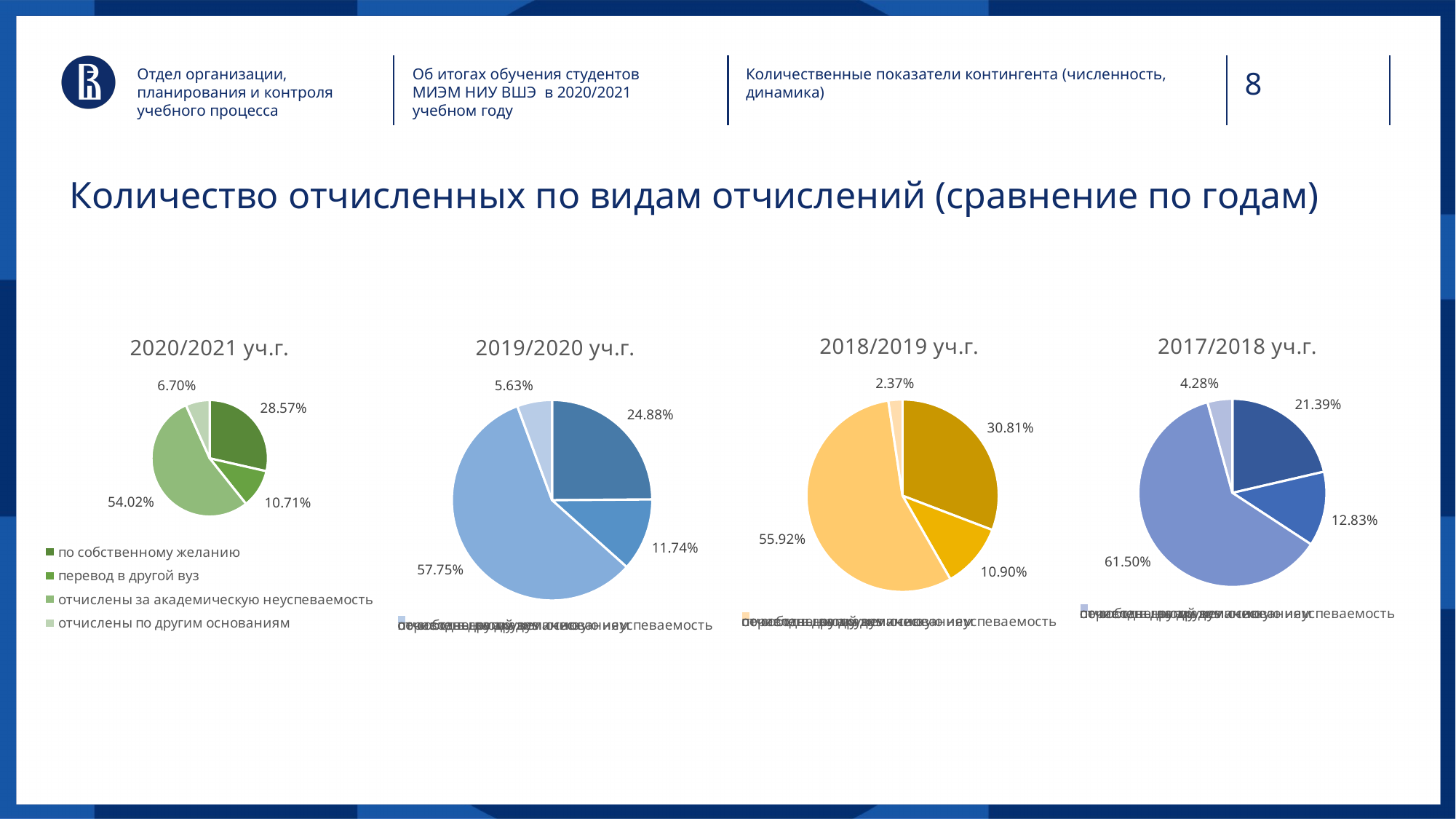
How many categories does the legend of the 2020/2021 уч.г. pie chart list? 4 What kind of chart is used for the 2020/2021 уч.г. data? pie chart In the 2020/2021 уч.г. pie chart, what is the difference between the shares for 'по собственному желанию' and 'перевод в другой вуз'? 17.86% In the 2017/2018 уч.г. pie chart, what is the share of the largest slice? 61.50% In the 2020/2021 уч.г. pie chart, which category has the smallest slice? отчислены по другим основаниям In the 2020/2021 уч.г. pie chart, what share is labelled for 'отчислены за академическую неуспеваемость'? 54.02% In the 2019/2020 уч.г. pie chart, what is the share of the largest slice? 57.75% In the 2020/2021 уч.г. pie chart, which category has the largest slice? отчислены за академическую неуспеваемость How many pie charts are shown on the slide? 4 In the 2020/2021 уч.г. pie chart, what share is labelled for 'перевод в другой вуз'? 10.71% In the 2020/2021 уч.г. pie chart, what share is labelled for 'по собственному желанию'? 28.57% In the 2018/2019 уч.г. pie chart, what is the share of the smallest slice? 2.37%